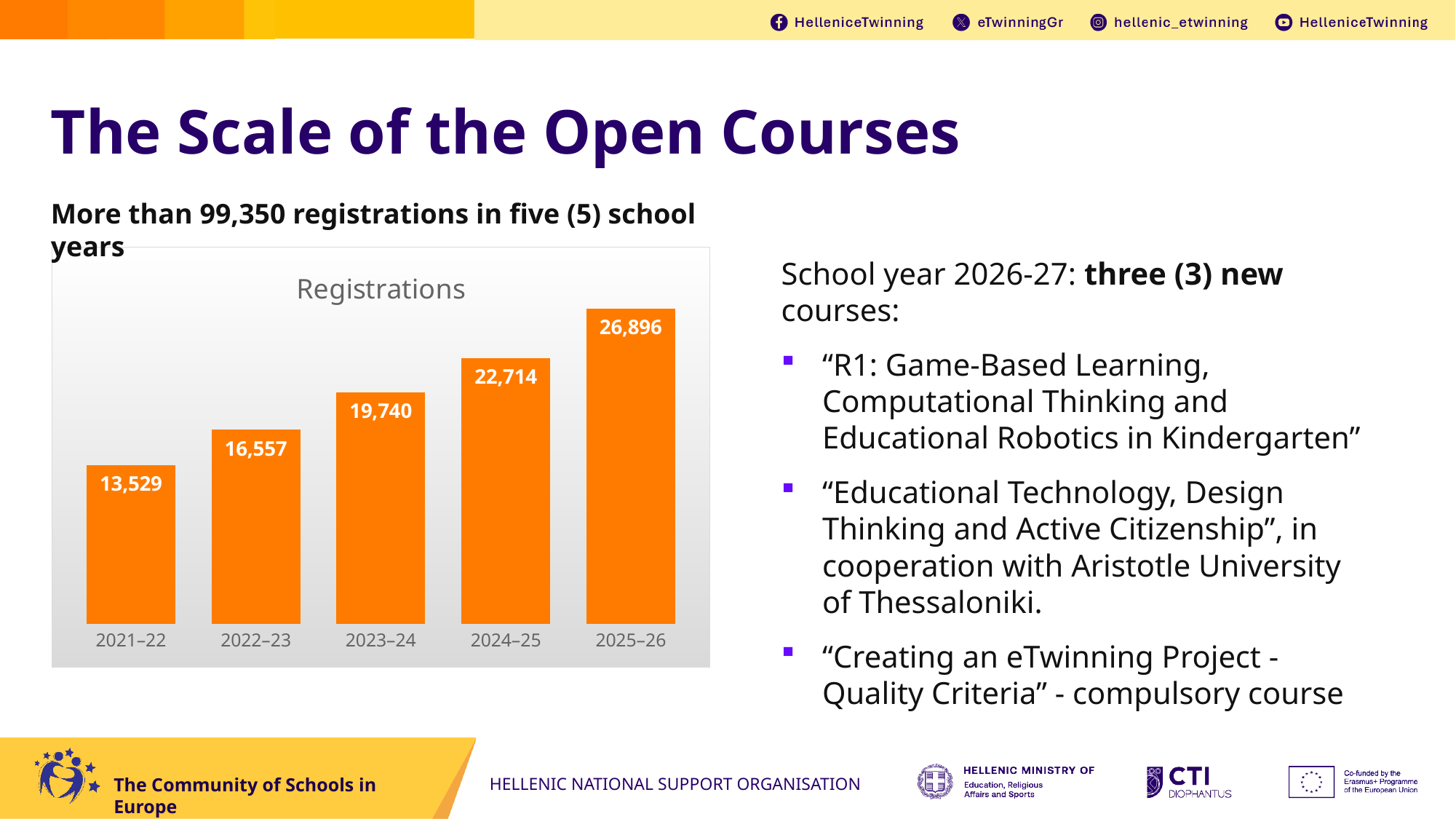
What is the value for 2021–22 in the Registrations chart? 13,529 Which school year has the highest number of registrations? 2025–26 What is the difference in registrations between 2022–23 and 2021–22? 3,028 What is the value for 2025–26 in the Registrations chart? 26,896 What kind of chart is used to show the registrations? Bar chart Which has more registrations, 2023–24 or 2024–25? 2024–25 How many school years are shown in the Registrations chart? 5 What is the value for 2023–24 in the Registrations chart? 19,740 What is the difference in registrations between 2025–26 and 2024–25? 4,182 What is the title of the chart on the slide? Registrations Do registrations rise or fall from 2021–22 to 2025–26? Rise Which school year has the lowest number of registrations? 2021–22